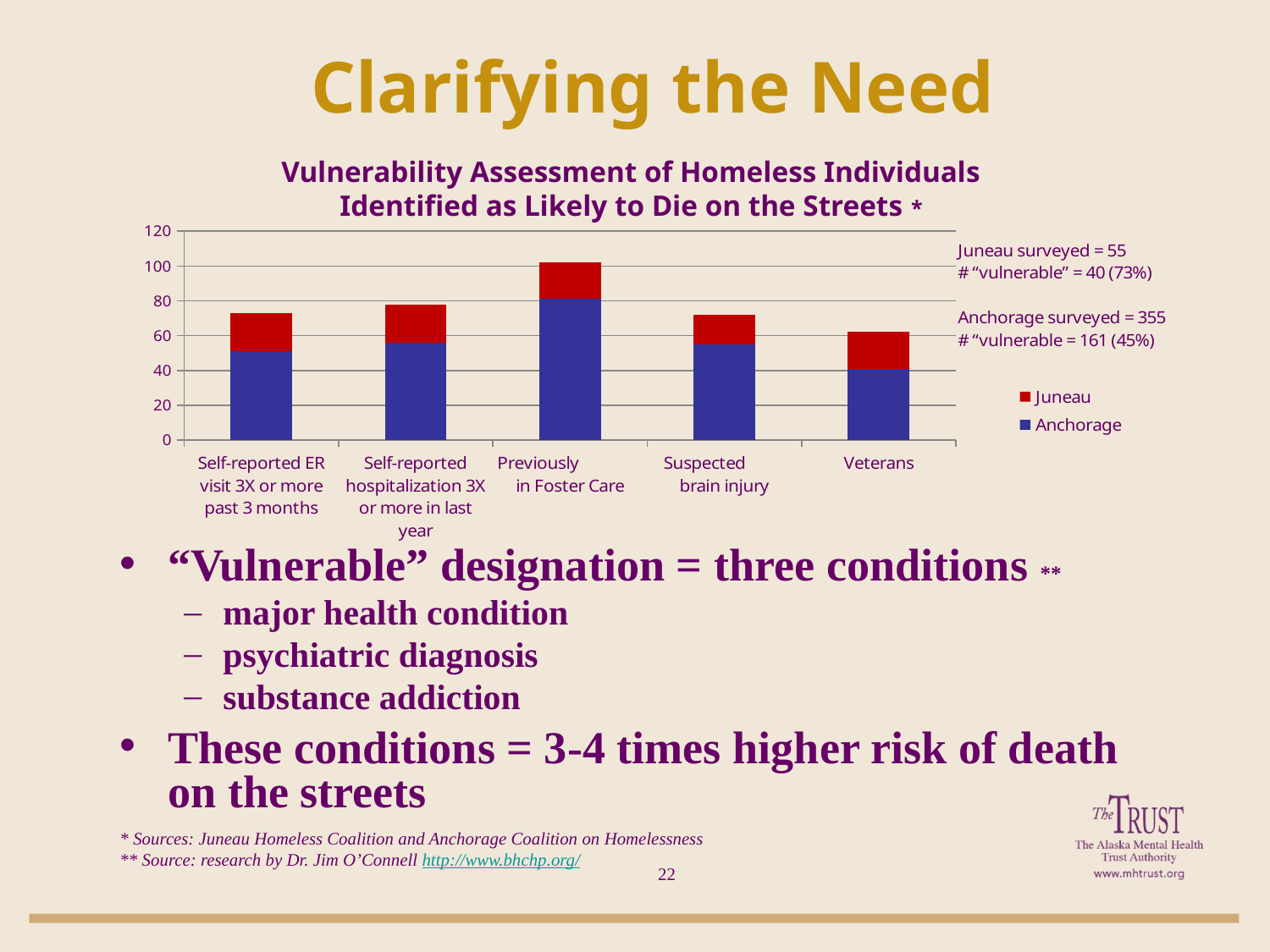
Is the Anchorage value for Previously in Foster Care greater or less than 60? greater Is the total stacked value for Veterans greater or less than 80? less Which category has the tallest stacked bar in the chart? Previously in Foster Care How many categories are shown along the x axis of the chart? 5 What is the title of the chart? Vulnerability Assessment of Homeless Individuals Identified as Likely to Die on the Streets Which series is shown in red in the chart? Juneau What kind of chart is shown on the slide? Stacked bar chart Which category has the shortest stacked bar in the chart? Veterans Which has the larger Anchorage value: Previously in Foster Care or Veterans? Previously in Foster Care How many series does the chart's legend list? 2 Is the Anchorage value for Veterans greater or less than 60? less